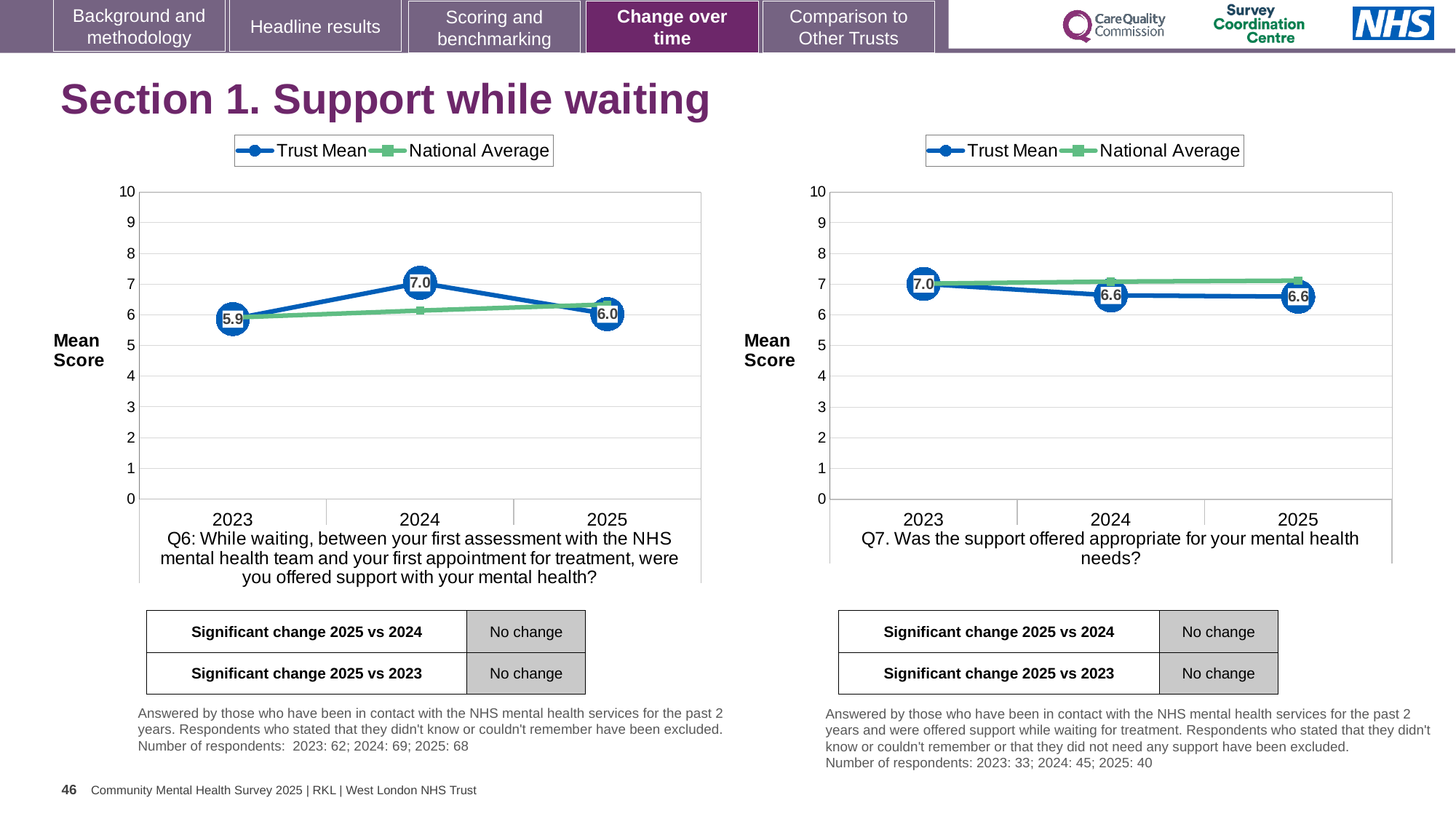
In the Q6 chart on the left, which year has the highest Trust Mean? 2024 In the Q7 chart on the right, what is the difference between the Trust Mean in 2023 and in 2024? 0.4 In the Q7 chart on the right, which year has the highest Trust Mean? 2023 In the Q6 chart on the left, what is the Trust Mean for 2023? 5.9 What type of chart is the Q6 chart on the left? Line chart In the Q6 chart on the left, is the Trust Mean for 2023 larger or smaller than the Trust Mean for 2025? smaller In the Q7 chart on the right, what is the Trust Mean for 2023? 7.0 In the Q6 chart on the left, is the National Average for 2023 greater or less than 7? less In the Q7 chart on the right, what is the Trust Mean for 2025? 6.6 In the Q6 chart on the left, what is the Trust Mean for 2024? 7.0 In the Q6 chart on the left, what is the difference between the Trust Mean in 2024 and in 2025? 1.0 How many series does the legend of the Q7 chart on the right list? 2